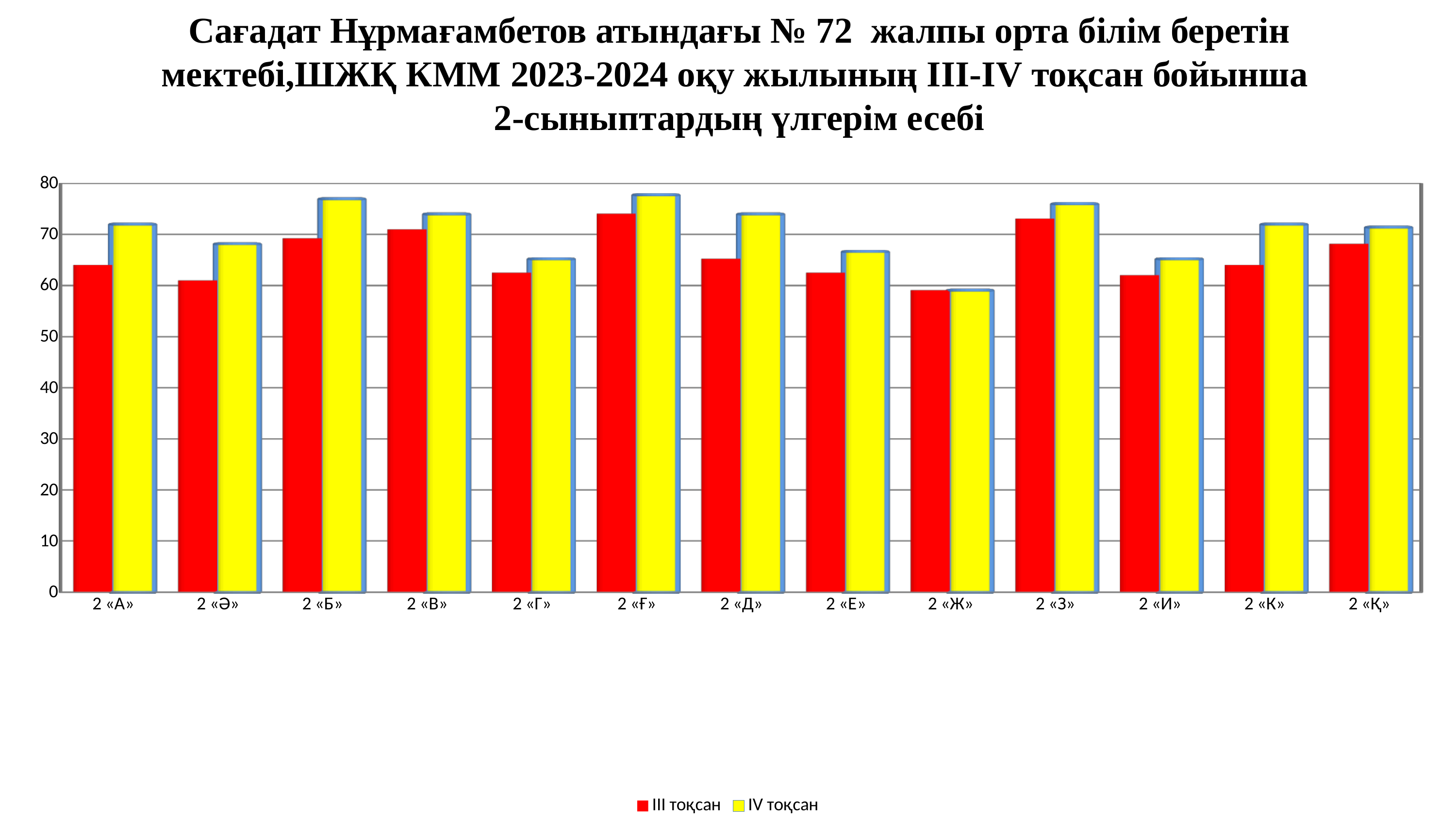
How many series does the legend list? 2 How many classes (categories) are shown on the x axis? 13 Is the IV тоқсан value for 2 «Б» greater or less than 70? greater Is the IV тоқсан value for 2 «Г» greater or less than 70? less Which class has the lowest IV тоқсан value? 2 «Ж» Is the III тоқсан value for 2 «А» greater or less than 60? greater Which series is shown in yellow? IV тоқсан Which is larger: the III тоқсан value for 2 «Ғ» or the III тоқсан value for 2 «Ә»? 2 «Ғ» For 2 «Б», which is larger: the III тоқсан value or the IV тоқсан value? IV тоқсан What kind of chart is shown on the slide? bar chart